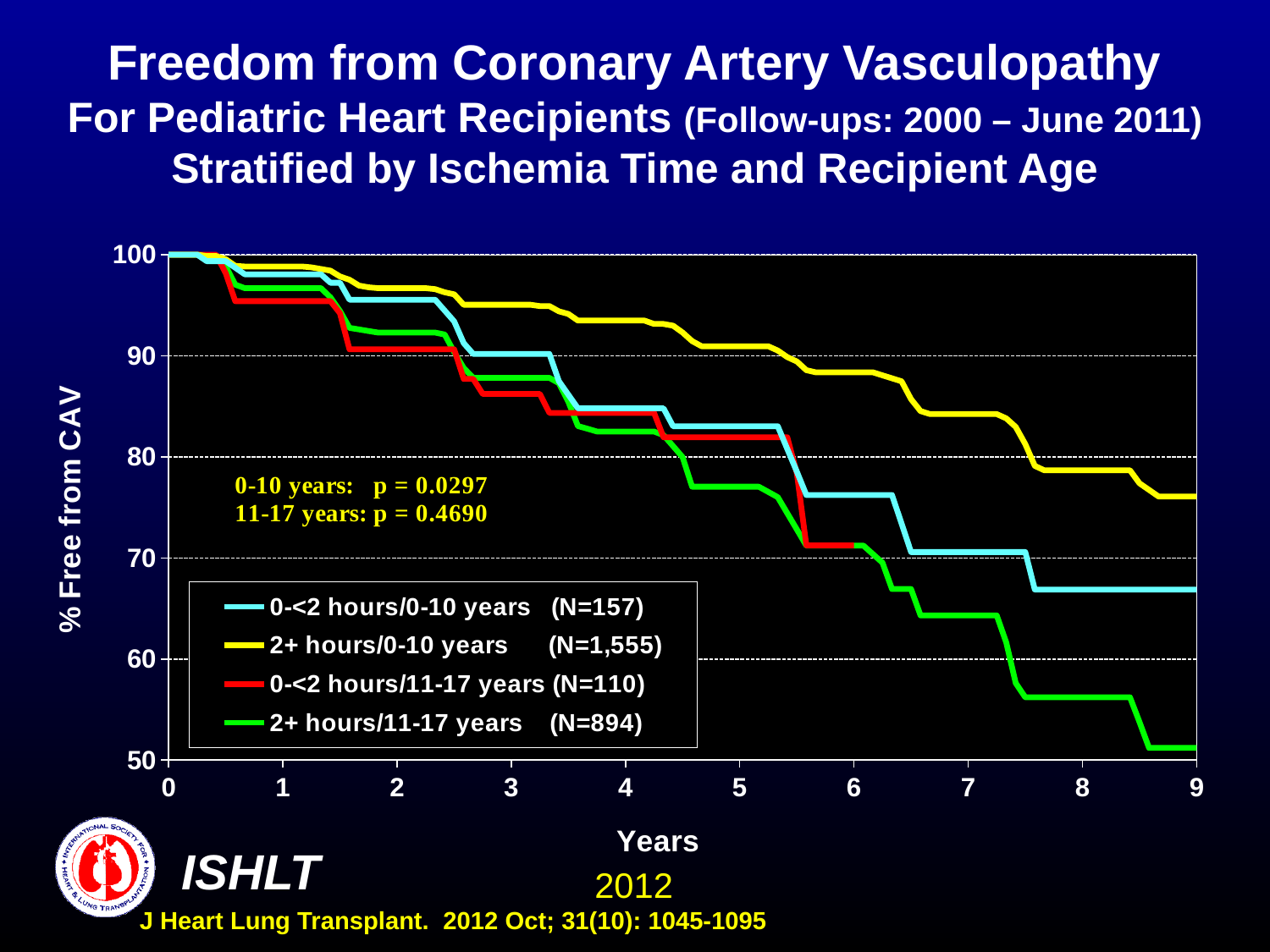
Is the value for 0-<2 hours/0-10 years at year 8 greater or less than 70? less Is the value for 2+ hours/0-10 years at year 5 greater or less than 90? greater Which series has the highest % free from CAV at year 9? 2+ hours/0-10 years What is the N shown in the legend for the 2+ hours/0-10 years series? N=1,555 Which series has the lowest % free from CAV at year 9? 2+ hours/11-17 years Is the value for 2+ hours/0-10 years at year 9 greater or less than 70? greater What kind of chart is shown on the slide? line chart What p-value is shown for the 0-10 years comparison? p = 0.0297 Do the curves rise or fall as years increase? fall At year 8, which series has the larger value: 2+ hours/0-10 years or 2+ hours/11-17 years? 2+ hours/0-10 years How many series does the legend list? 4